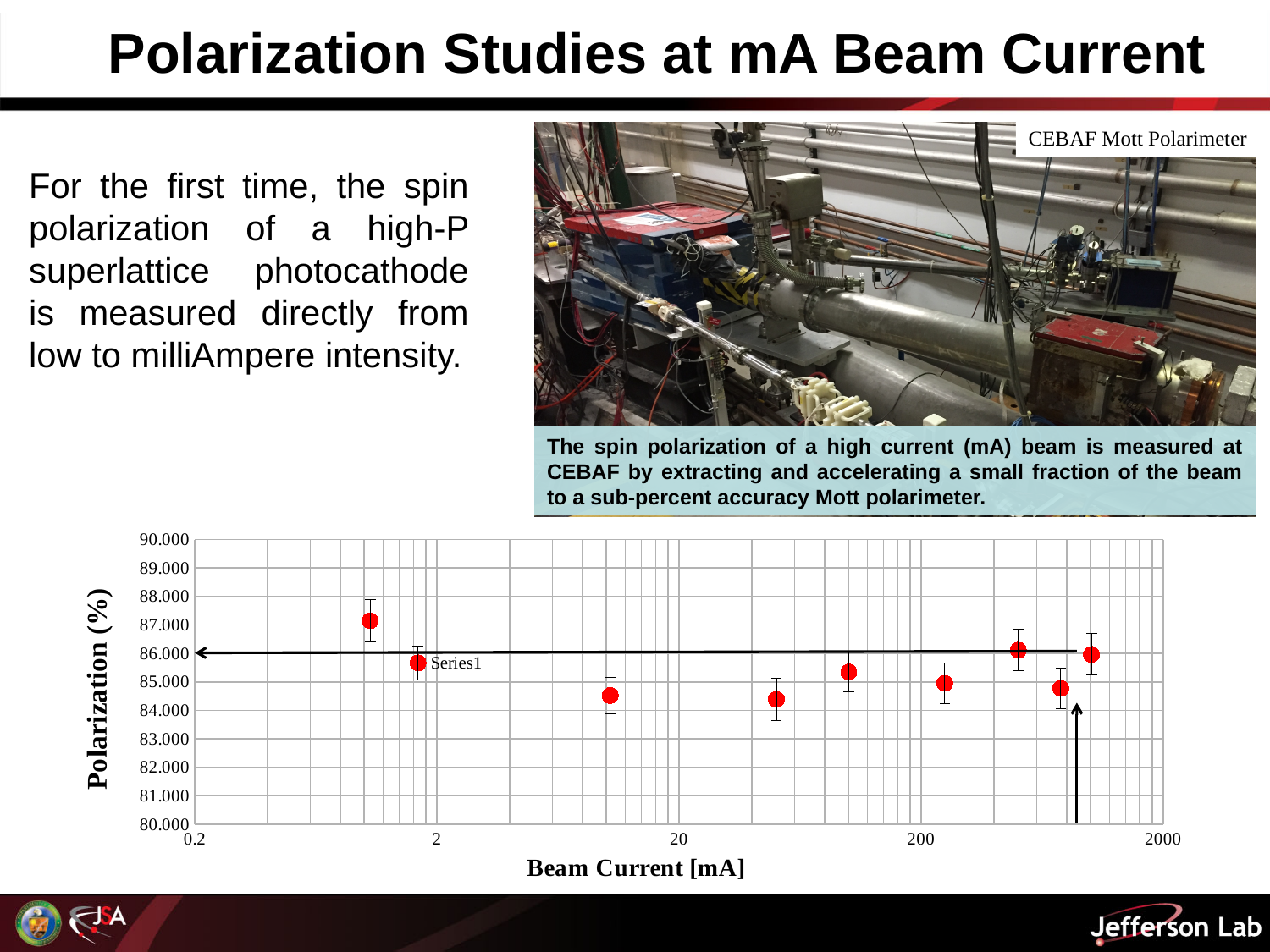
Which data point has the highest polarization value? the leftmost point What is the title of the x axis of the chart? Beam Current [mA] Is the polarization value for the leftmost data point (near 1 mA) greater or less than 86.000? greater What kind of chart is shown at the bottom of the slide? scatter chart How many data points are plotted in the chart? 9 Which has the larger polarization value: the leftmost data point (near 1 mA) or the data point near 10 mA? the leftmost point (near 1 mA) Is the polarization value for the data point near 500 mA greater or less than 85.000? greater What is the title of the y axis of the chart? Polarization (%) Is the polarization value for the data point near 40 mA greater or less than 85.000? less Which has the larger polarization value: the data point near 500 mA or the data point near 800 mA? the point near 500 mA